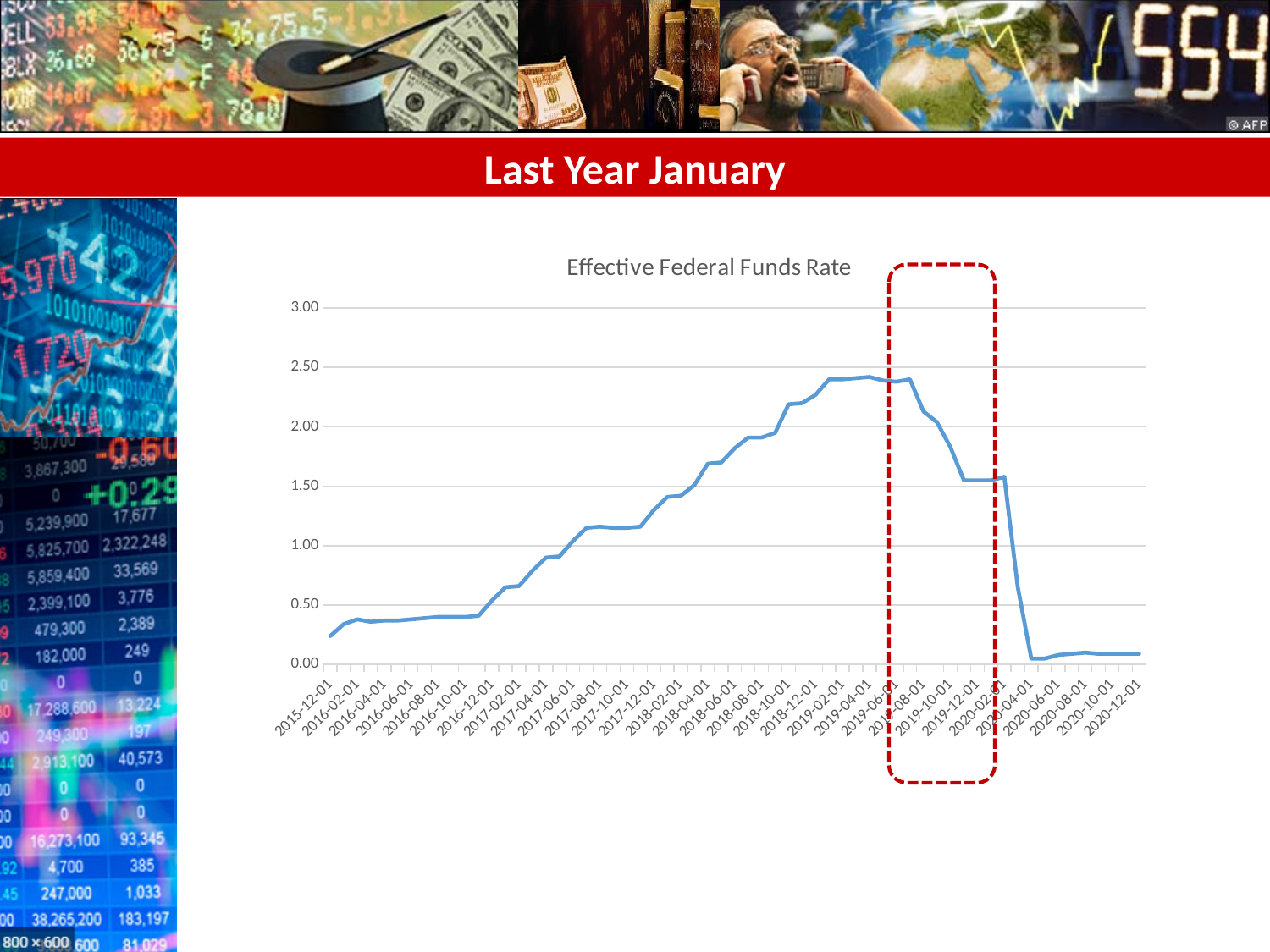
What colour is the dashed box highlighting part of the chart? red Is the value for 2019-10-01 greater or less than 1.50? greater Is the value for 2018-02-01 greater or less than 1.00? greater Is the value for 2020-06-01 greater or less than 0.50? less Which is larger, the value for 2018-06-01 or the value for 2020-10-01? 2018-06-01 Does the Effective Federal Funds Rate rise or fall between 2015-12-01 and 2019-02-01? rise Does the Effective Federal Funds Rate rise or fall between 2019-08-01 and 2020-06-01? fall What is the title of the chart? Effective Federal Funds Rate What kind of chart is shown on the slide? line chart